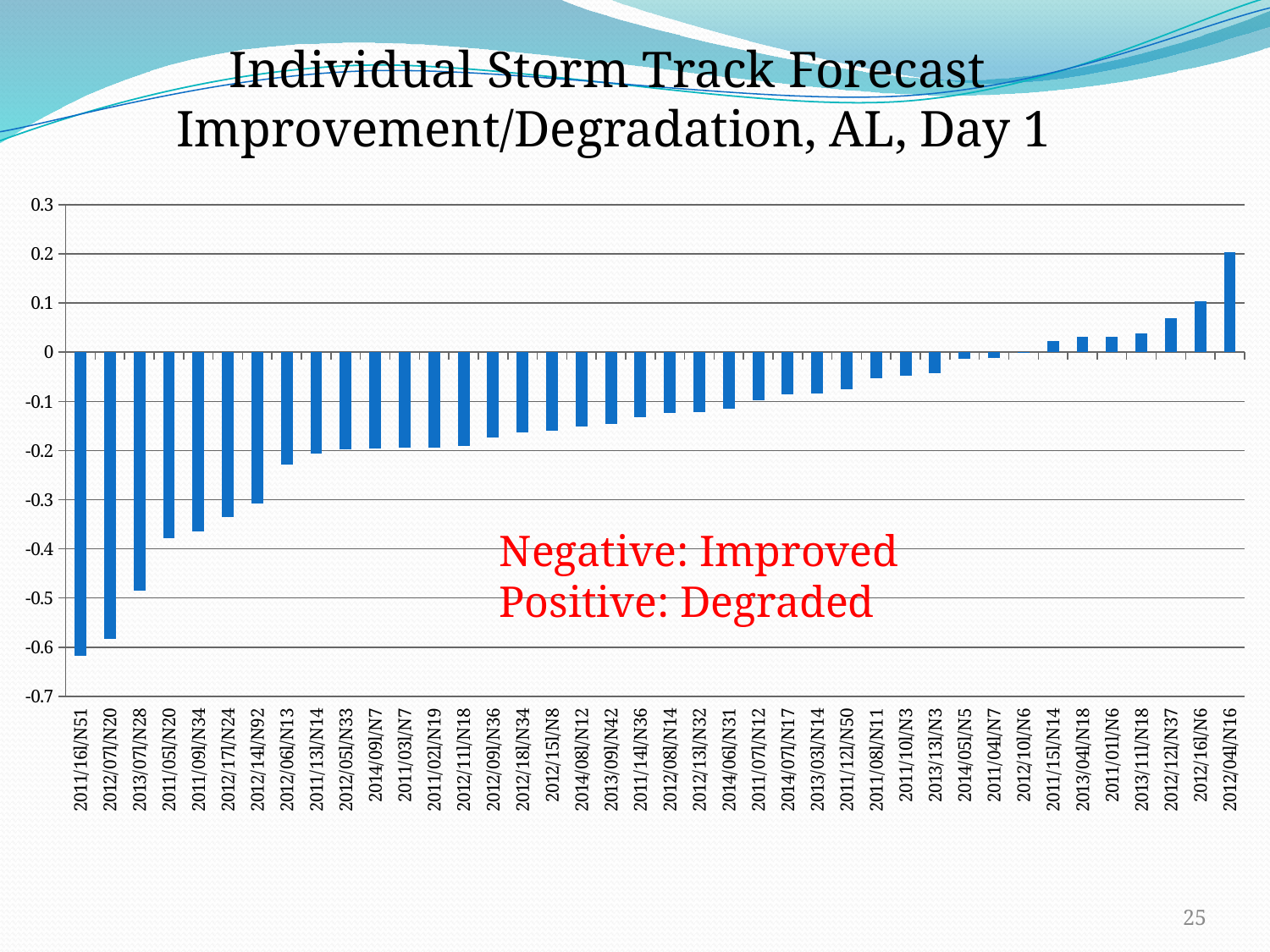
What is the title of the chart? Individual Storm Track Forecast Improvement/Degradation, AL, Day 1 Is the value for 2012/06/N13 greater or less than -0.2? less How many storm categories are plotted on the x axis? 40 Which storm has the highest value? 2012/04l/N16 Is the value for 2012/07/N20 greater or less than -0.5? less Do the values generally rise or fall moving from left to right along the x axis? Rise According to the red annotation on the chart, what does a negative value indicate? Improved Which storm has the lowest (most negative) value? 2011/16l/N51 Which has the larger value, 2012/07/N20 or 2013/07/N28? 2013/07l/N28 What kind of chart is shown on the slide? Bar chart Is the value for 2012/12/N37 greater or less than 0.1? less